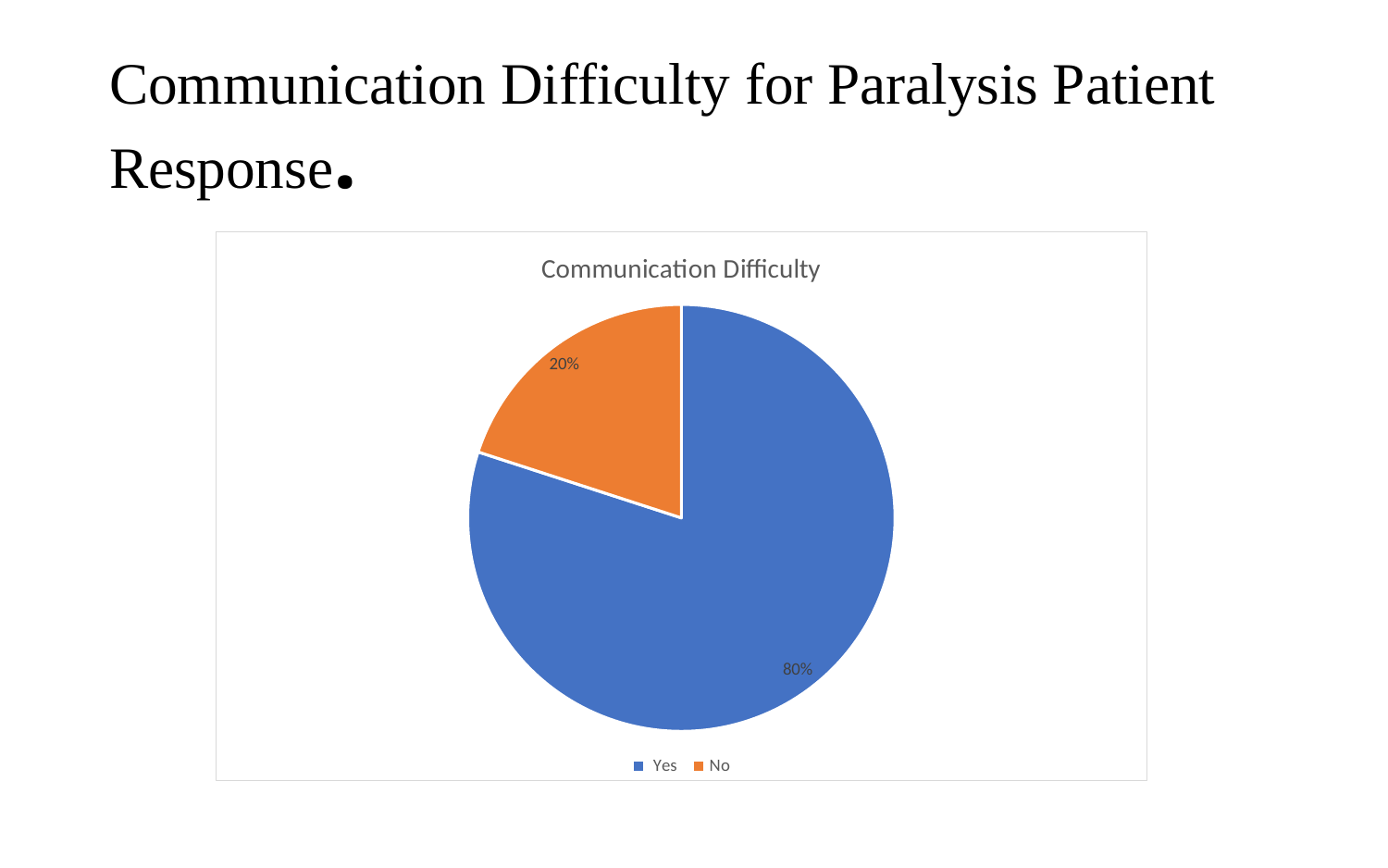
How many slices does the pie chart have? 2 What is the difference in percentage points between the "Yes" and "No" slices? 60 How many entries does the legend list? 2 What share of the pie does the "No" slice represent? 20% What colour is the "Yes" slice? blue Which category has the largest slice of the pie? Yes Which category has the smallest slice of the pie? No What is the title of the chart? Communication Difficulty Which slice is larger, "Yes" or "No"? Yes What percentage of the pie is labelled "No"? 20% What percentage of the pie is labelled "Yes"? 80% What kind of chart is shown on the slide? pie chart